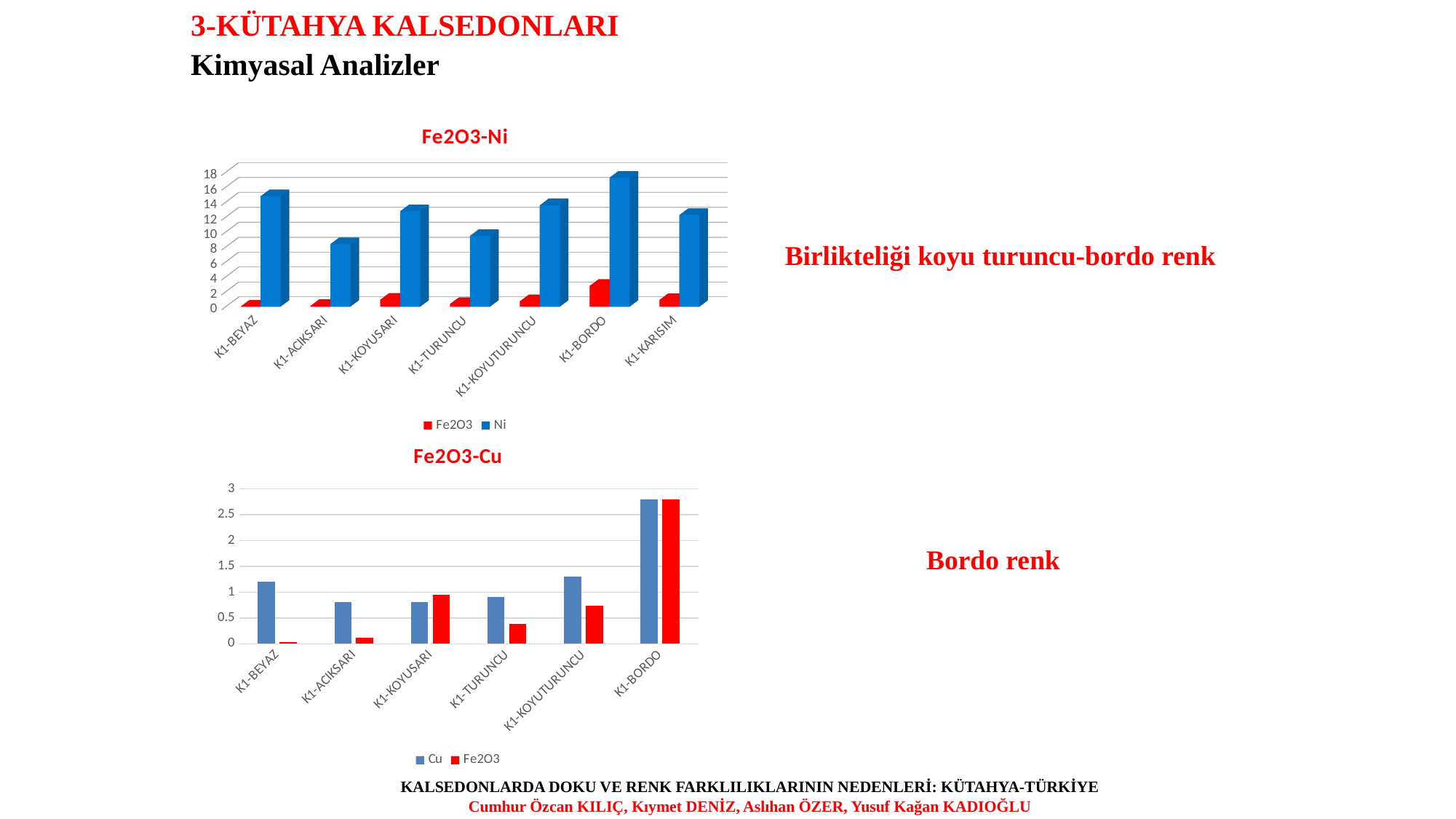
In the Fe2O3-Cu chart, which category has the highest Cu value? K1-BORDO In the Fe2O3-Cu chart, is the Cu value for K1-BORDO greater or less than 2.5? greater How many categories are shown in the Fe2O3-Ni chart? 7 In the Fe2O3-Cu chart, which is larger for K1-TURUNCU, Cu or Fe2O3? Cu How many series does the legend of the Fe2O3-Ni chart list? 2 In the Fe2O3-Ni chart, which category has the highest Fe2O3 value? K1-BORDO What type of chart is the Fe2O3-Cu chart? bar chart In the Fe2O3-Ni chart, which category has the highest Ni value? K1-BORDO How many categories are shown in the Fe2O3-Cu chart? 6 In the Fe2O3-Ni chart, is the Ni value for K1-BORDO greater or less than 16? greater In the Fe2O3-Cu chart, which category has the lowest Fe2O3 value? K1-BEYAZ In the Fe2O3-Ni chart, is the Ni value for K1-ACIKSARI greater or less than 12? less